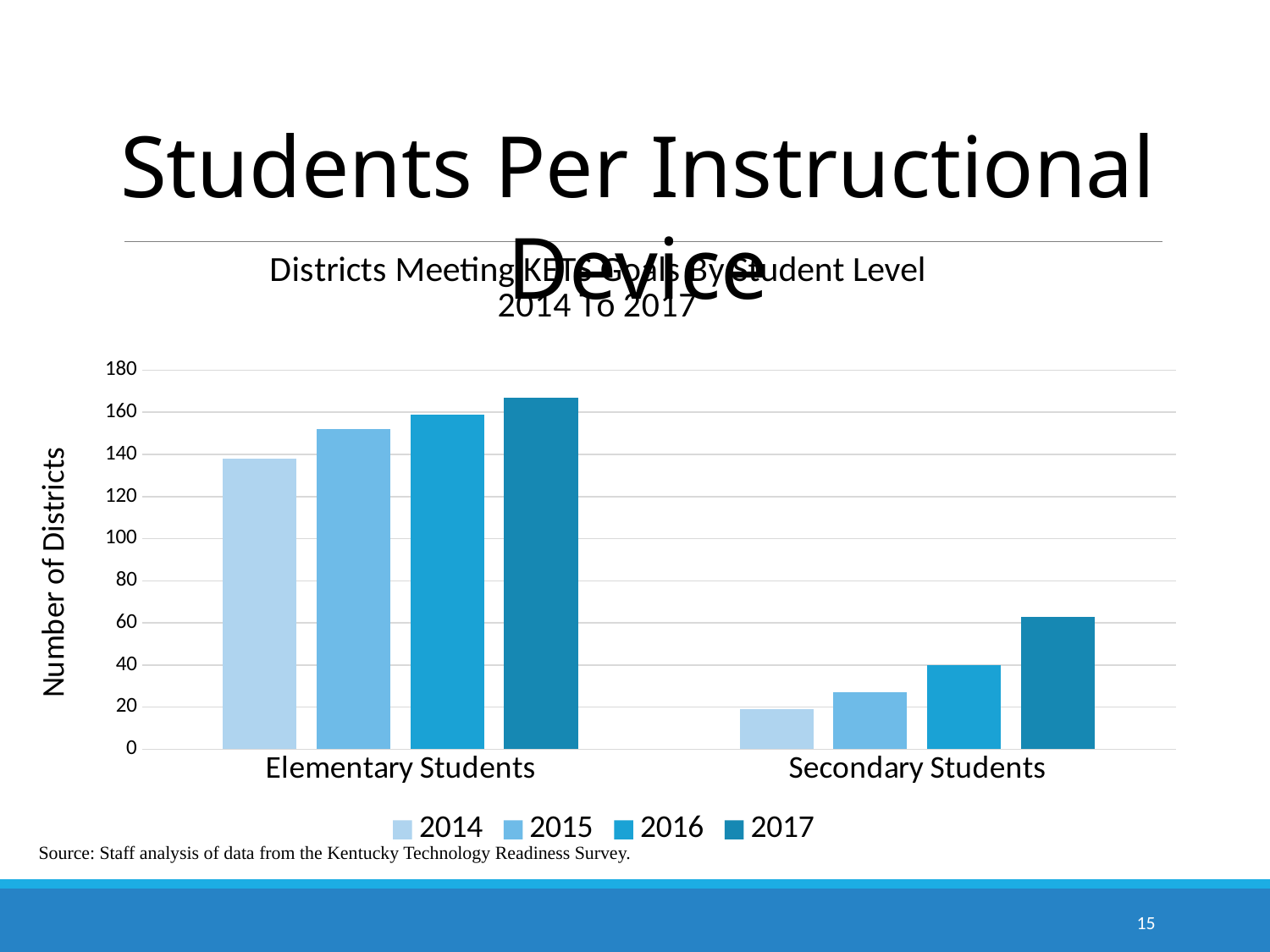
Which is larger: the 2016 value for Elementary Students or the 2016 value for Secondary Students? Elementary Students Which year has the highest value for Elementary Students? 2017 What kind of chart is shown on the slide? bar chart Is the value for Secondary Students in 2015 greater or less than 40? less Is the value for Elementary Students in 2015 greater or less than 140? greater How many series does the chart legend list? 4 Which year has the lowest value for Secondary Students? 2014 Is the value for Secondary Students in 2017 greater or less than 40? greater Do the values for Secondary Students rise or fall from 2014 to 2017? rise What is the label on the vertical axis of the chart? Number of Districts How many student-level categories are shown on the x axis? 2